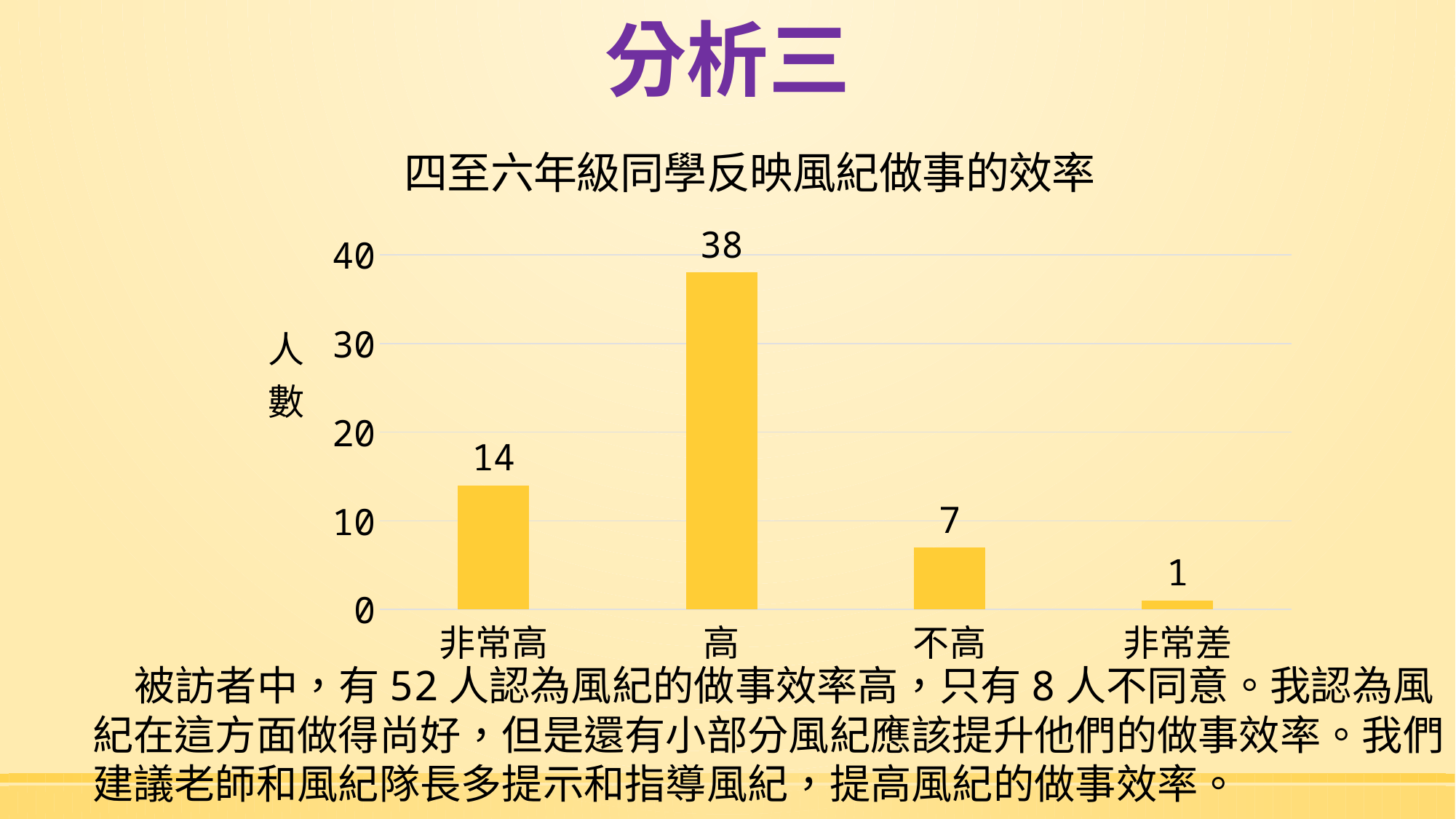
Which category has the highest value? 高 What is the value for 非常差? 1 How many categories are shown on the x axis? 4 What is the value for 高? 38 What is the value for 非常高? 14 What is the value for 不高? 7 Which is larger, the value for 非常高 or the value for 不高? 非常高 What kind of chart is shown on the slide? bar chart Is the value for 高 greater or less than 30? greater What is the title of the chart? 四至六年級同學反映風紀做事的效率 What is the difference between the values for 高 and 非常高? 24 Which category has the lowest value? 非常差